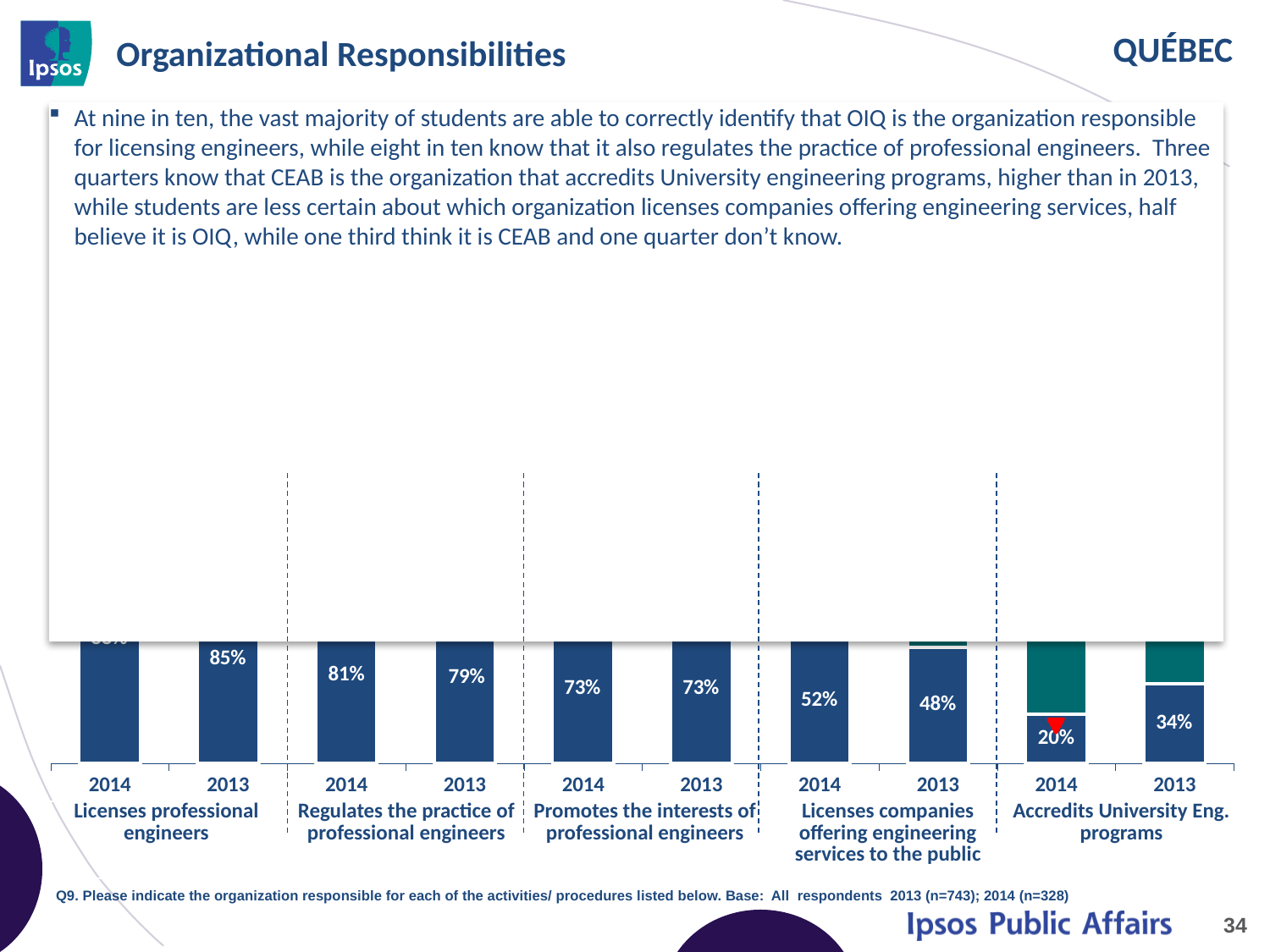
What is the value shown for 2013 under "Accredits University Eng. programs"? 34% What kind of chart is shown on the slide? Bar chart What is the value shown for 2014 under "Licenses companies offering engineering services to the public"? 52% Are the 2014 and 2013 values under "Promotes the interests of professional engineers" the same or different? The same (73%) What is the value shown for 2013 under "Regulates the practice of professional engineers"? 79% What is the difference between the 2014 and 2013 values under "Licenses companies offering engineering services to the public"? 4 percentage points What is the value shown for 2014 under "Promotes the interests of professional engineers"? 73% What is the value shown for 2013 under "Licenses professional engineers"? 85% Which is larger: the 2014 value or the 2013 value under "Regulates the practice of professional engineers"? 2014 What is the value shown for 2014 under "Regulates the practice of professional engineers"? 81% How many activity categories are shown along the x axis of the chart? 5 What is the difference between the 2013 and 2014 values under "Accredits University Eng. programs"? 14 percentage points